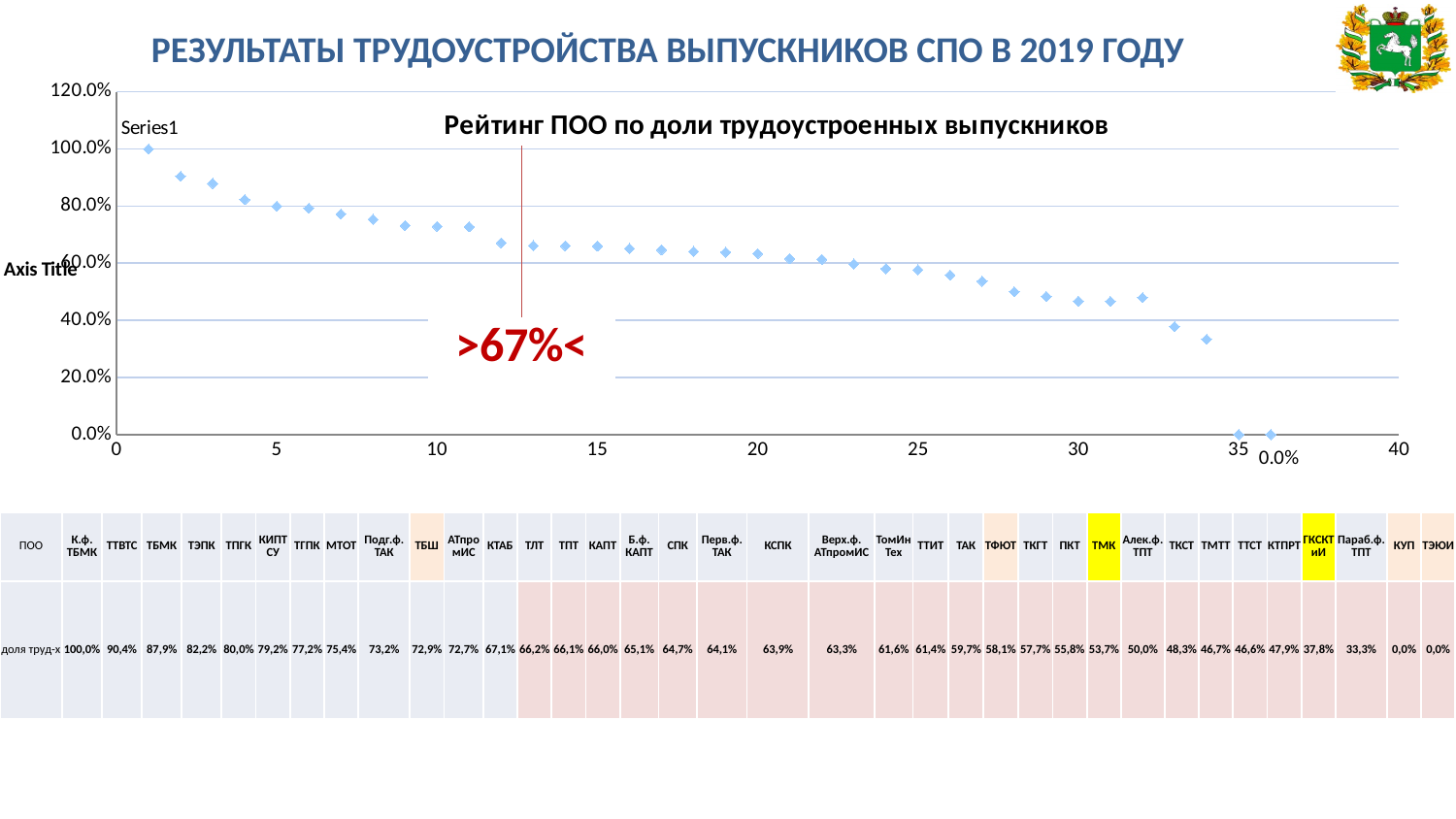
Is the value of the point at x = 34 greater or less than 40.0%? less Is the value of the first point (at x = 1) greater or less than 80.0%? greater Do the plotted values rise or fall as you move from left to right along the x axis? fall Is the value of the point at x = 10 greater or less than 60.0%? greater Which is larger: the value of the point at x = 5 or the value of the point at x = 25? the point at x = 5 What is the title of the chart? Рейтинг ПОО по доли трудоустроенных выпускников How many series does the chart legend list? 1 What value is printed as a data label next to the last points of the chart? 0.0% What kind of chart is shown on the slide? scatter chart What red text is written inside the chart area below the title? >67%<